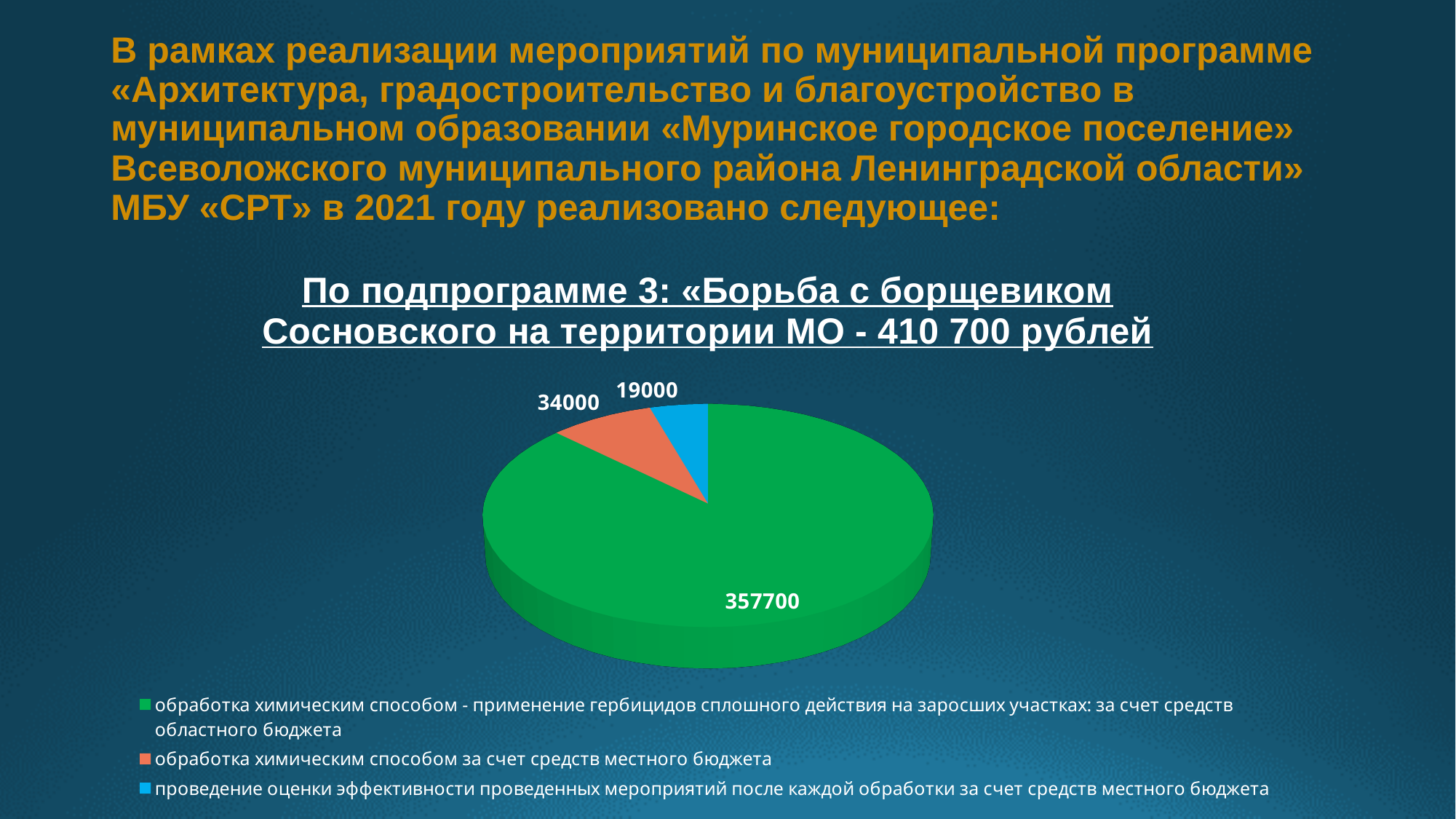
How many slices does the pie chart have? 3 How many entries does the legend of the pie chart list? 3 Which category has the largest slice of the pie chart? обработка химическим способом - применение гербицидов сплошного действия на заросших участках: за счет средств областного бюджета What is the difference between the value for «обработка химическим способом за счет средств местного бюджета» and «проведение оценки эффективности проведенных мероприятий после каждой обработки за счет средств местного бюджета»? 15000 What is the value for «обработка химическим способом - применение гербицидов сплошного действия на заросших участках: за счет средств областного бюджета»? 357700 Which is larger: the value for «обработка химическим способом за счет средств местного бюджета» or the value for «проведение оценки эффективности проведенных мероприятий после каждой обработки за счет средств местного бюджета»? обработка химическим способом за счет средств местного бюджета What kind of chart is shown on the slide? pie chart Which category has the smallest slice of the pie chart? проведение оценки эффективности проведенных мероприятий после каждой обработки за счет средств местного бюджета What is the value for «проведение оценки эффективности проведенных мероприятий после каждой обработки за счет средств местного бюджета»? 19000 What is the value for «обработка химическим способом за счет средств местного бюджета»? 34000 What colour is the largest slice of the pie chart? green What is the difference between the value for chemical treatment from the regional budget (областного бюджета) and chemical treatment from the local budget (местного бюджета)? 323700